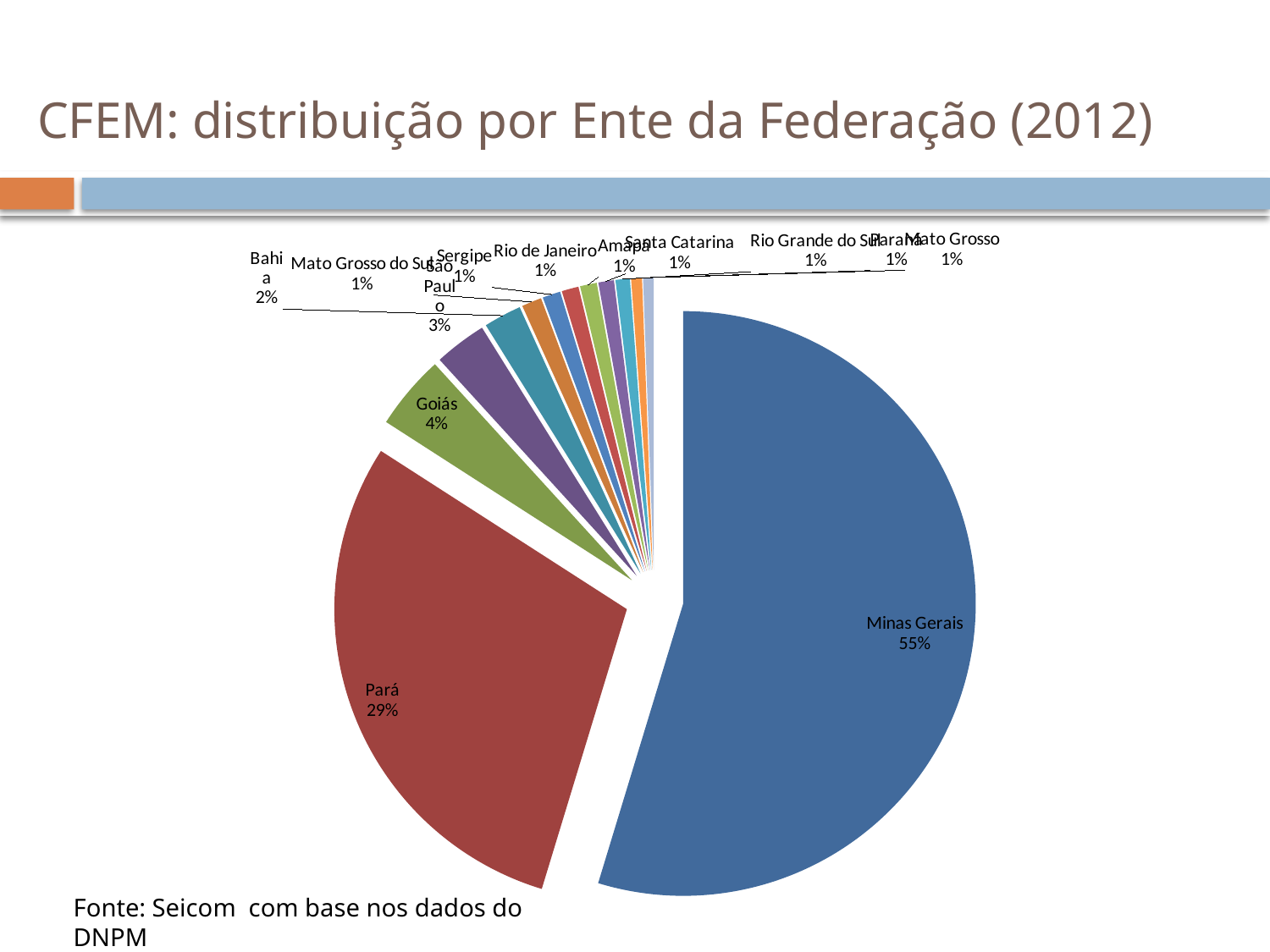
Which state has the largest slice of the pie? Minas Gerais What is the value shown for Goiás? 4% What is the combined share of Minas Gerais and Pará? 84% What is the value shown for São Paulo? 3% What is the title of the slide? CFEM: distribuição por Ente da Federação (2012) What is the value shown for Pará? 29% What is the value shown for Bahia? 2% What is the difference in percentage points between Minas Gerais and Pará? 26 What is the value shown for Santa Catarina? 1% Which is larger, the slice for Pará or the slice for Goiás? Pará What kind of chart is shown on the slide? Pie chart What share of the pie does Minas Gerais hold? 55%